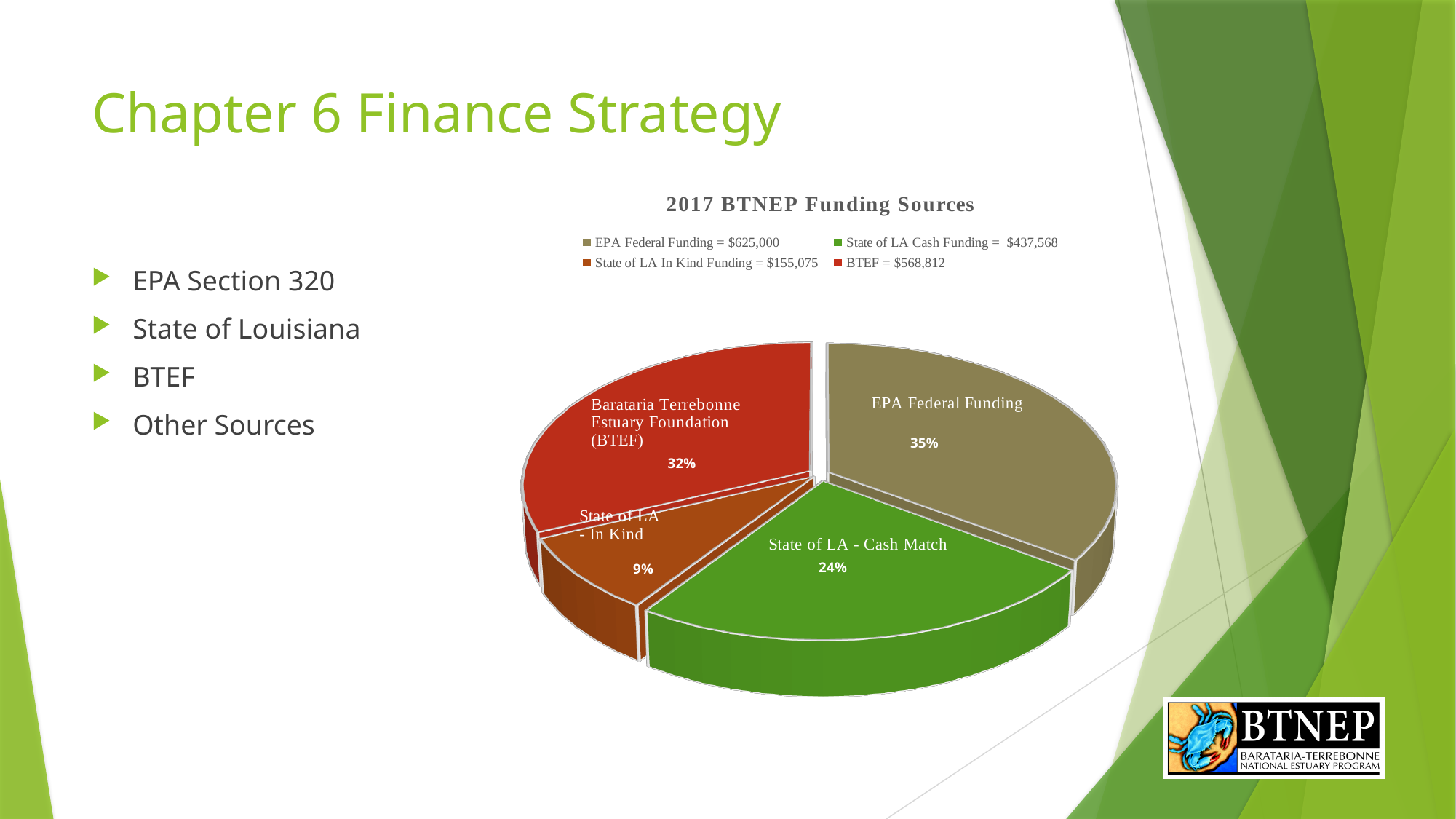
How many slices does the pie chart have? 4 What percentage share of the pie is EPA Federal Funding? 35% What percentage share of the pie is State of LA - In Kind? 9% Which funding source has the smallest share of the pie? State of LA - In Kind According to the legend, what is the dollar amount of BTEF funding? $568,812 What percentage share of the pie is Barataria Terrebonne Estuary Foundation (BTEF)? 32% Which is larger, the share for BTEF or the share for State of LA - Cash Match? BTEF What is the title of the pie chart? 2017 BTNEP Funding Sources What type of chart is shown on the slide? pie chart According to the legend, what is the dollar amount of EPA Federal Funding? $625,000 Which funding source has the largest share of the pie? EPA Federal Funding